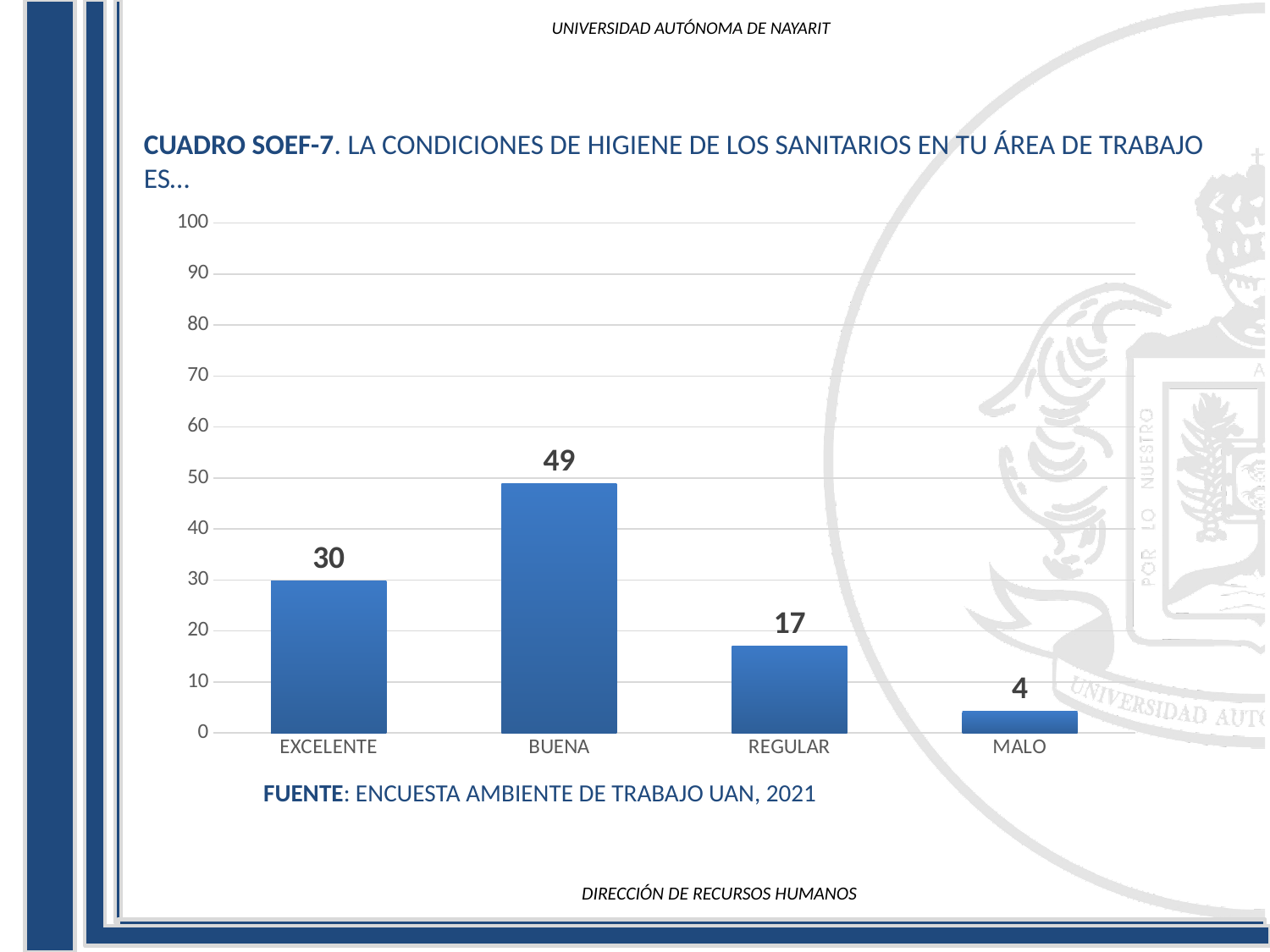
Is the value for BUENA greater or less than 40? greater What is the difference between the values for BUENA and EXCELENTE? 19 What is the value for BUENA? 49 What is the difference between the values for REGULAR and MALO? 13 What kind of chart is shown on the slide? bar chart Which is larger, the value for EXCELENTE or the value for REGULAR? EXCELENTE What is the value for MALO? 4 Which category has the highest value? BUENA How many categories are shown on the x axis? 4 Which category has the lowest value? MALO What is the value for REGULAR? 17 What is the value for EXCELENTE? 30